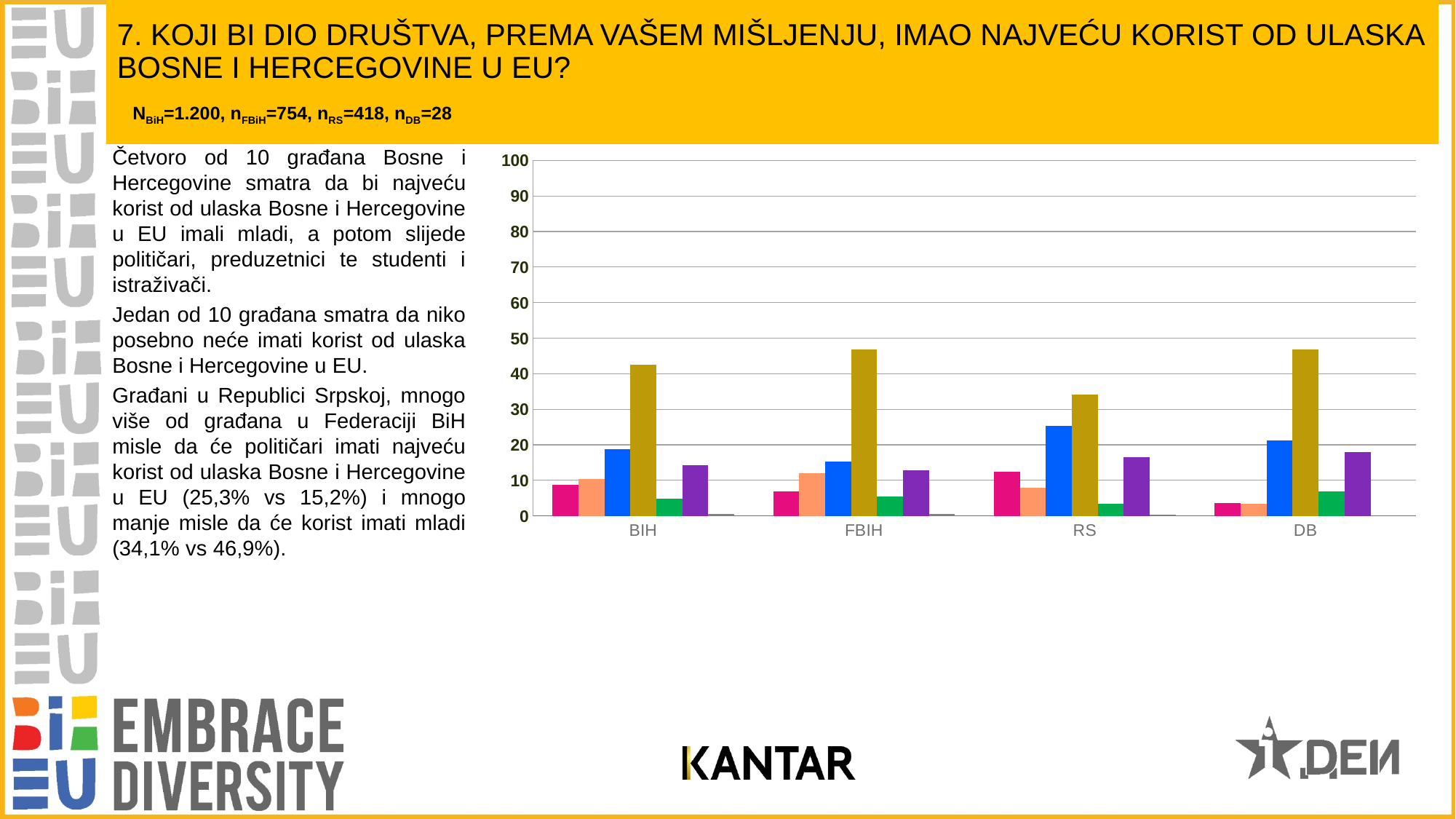
Which is larger, the pink bar for RS or the pink bar for DB? the pink bar for RS What kind of chart is shown on the slide? bar chart Which is larger, the blue bar for RS or the blue bar for FBIH? the blue bar for RS In which category is the gold bar the lowest? RS Is the gold bar for BIH greater or less than 50? less Is the gold bar for RS greater or less than 30? greater How many categories are shown on the x axis of the chart? 4 Which colour bar is the tallest in every category group of the chart? gold Is the blue bar for RS greater or less than 20? greater What is the highest value shown on the y axis of the chart? 100 What are the categories on the x axis of the chart? BIH, FBIH, RS, DB